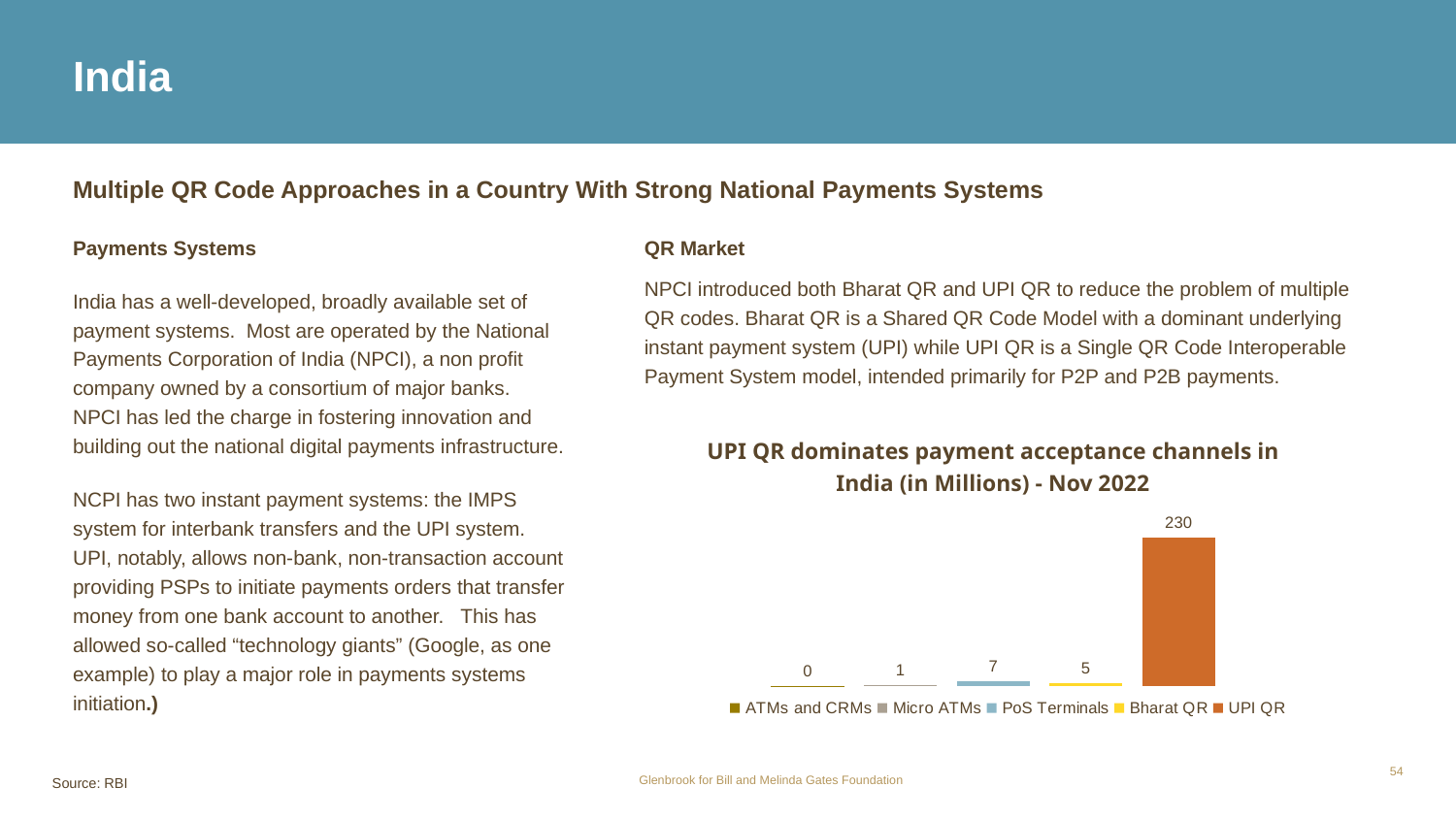
Which payment acceptance channel has the lowest value in the chart? ATMs and CRMs Which payment acceptance channel has the highest value in the chart? UPI QR What is the title of the chart? UPI QR dominates payment acceptance channels in India (in Millions) - Nov 2022 How many series does the chart legend list? 5 What is the value for Micro ATMs in the chart? 1 What is the value for UPI QR in the chart? 230 What is the difference between the values for UPI QR and PoS Terminals? 223 What is the value for PoS Terminals in the chart? 7 What is the value for Bharat QR in the chart? 5 What kind of chart is shown on the slide? Bar chart Which is larger, the value for PoS Terminals or the value for Bharat QR? PoS Terminals What is the value for ATMs and CRMs in the chart? 0